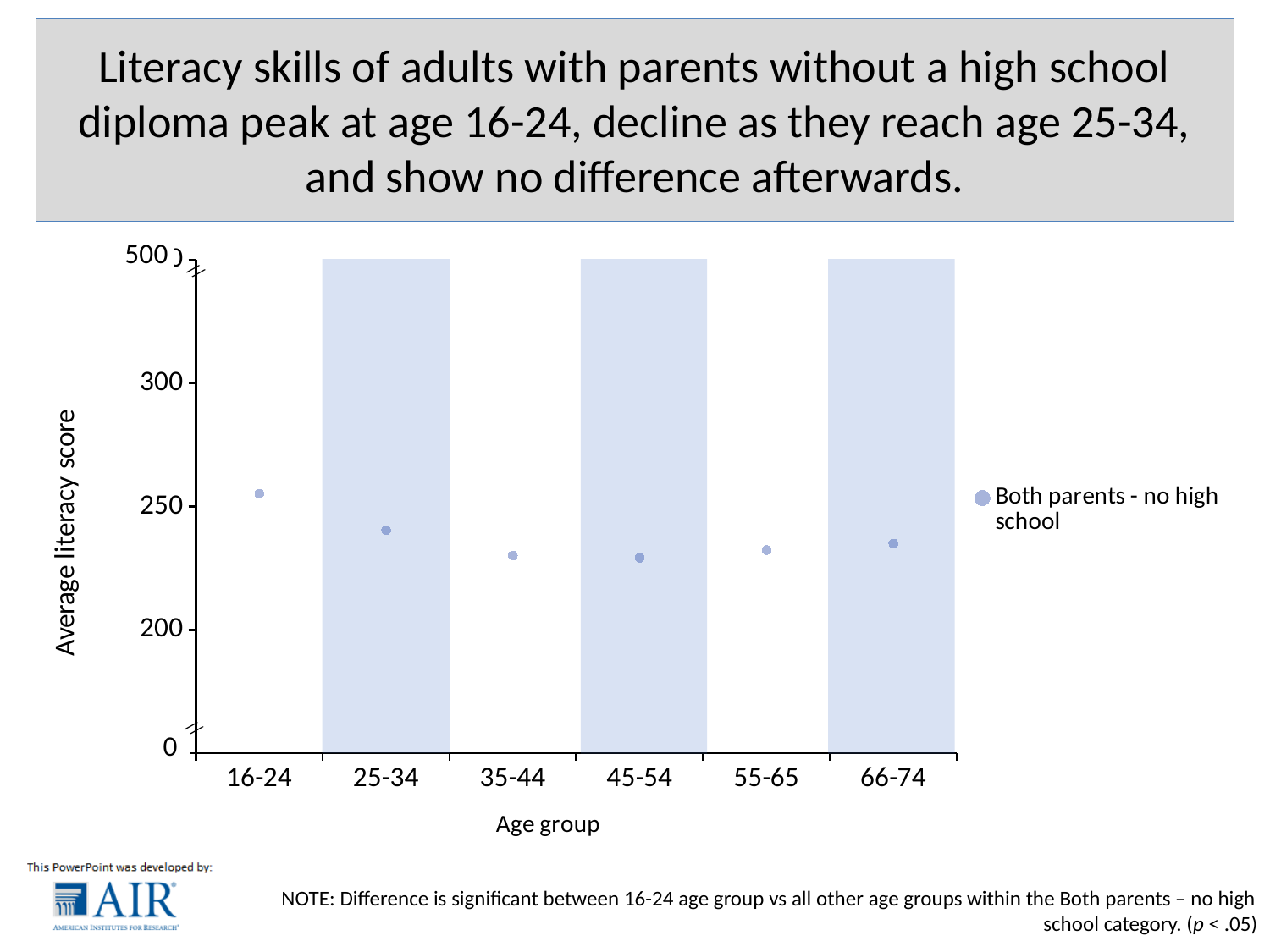
What kind of chart is shown on the slide? Scatter (dot) chart Which age group has the highest average literacy score? 16-24 How many series does the legend list? 1 How many age groups are plotted on the x axis? 6 Is the average literacy score for the 25-34 age group greater or less than 250? less Is the average literacy score for the 16-24 age group greater or less than 250? greater Is the average literacy score for the 35-44 age group greater or less than 200? greater Do the average literacy scores rise or fall from the 16-24 age group to the 35-44 age group? fall Which has a higher average literacy score, the 16-24 age group or the 25-34 age group? 16-24 Which has a higher average literacy score, the 25-34 age group or the 35-44 age group? 25-34 What is the series name shown in the legend? Both parents - no high school